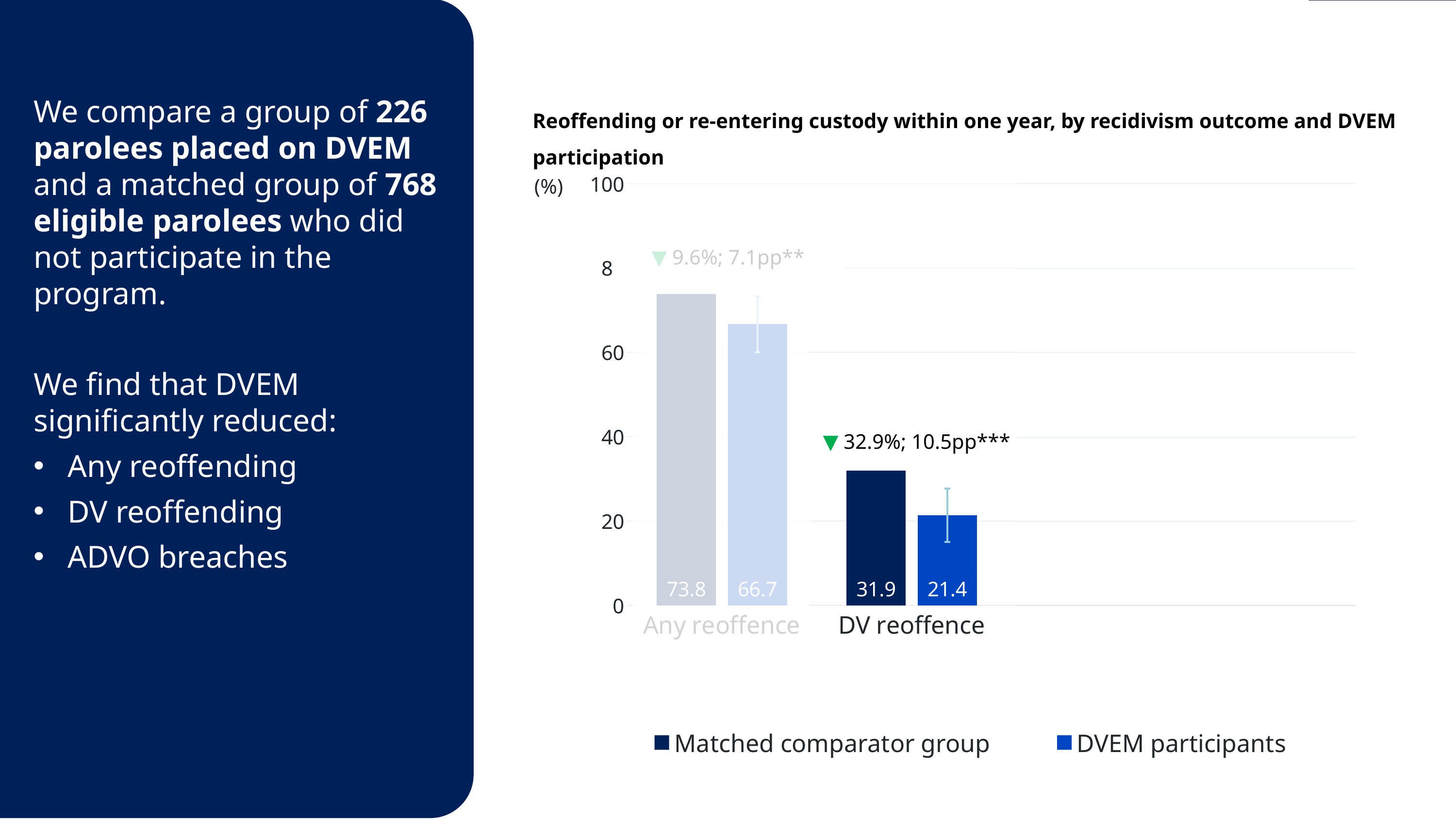
What is the value for DVEM participants for Any reoffence? 66.7 Which bar has the lowest value on the chart? DVEM participants, DV reoffence For Any reoffence, which is larger: the Matched comparator group or DVEM participants? Matched comparator group What kind of chart is shown on the slide? Bar chart What is the difference between the Matched comparator group and DVEM participants for Any reoffence? 7.1 What is the value for DVEM participants for DV reoffence? 21.4 What is the difference between the Matched comparator group and DVEM participants for DV reoffence? 10.5 How many series does the legend list? 2 How many categories are shown on the x axis? 2 What is the value for the Matched comparator group for Any reoffence? 73.8 Which category has the highest value for the Matched comparator group? Any reoffence What is the value for the Matched comparator group for DV reoffence? 31.9